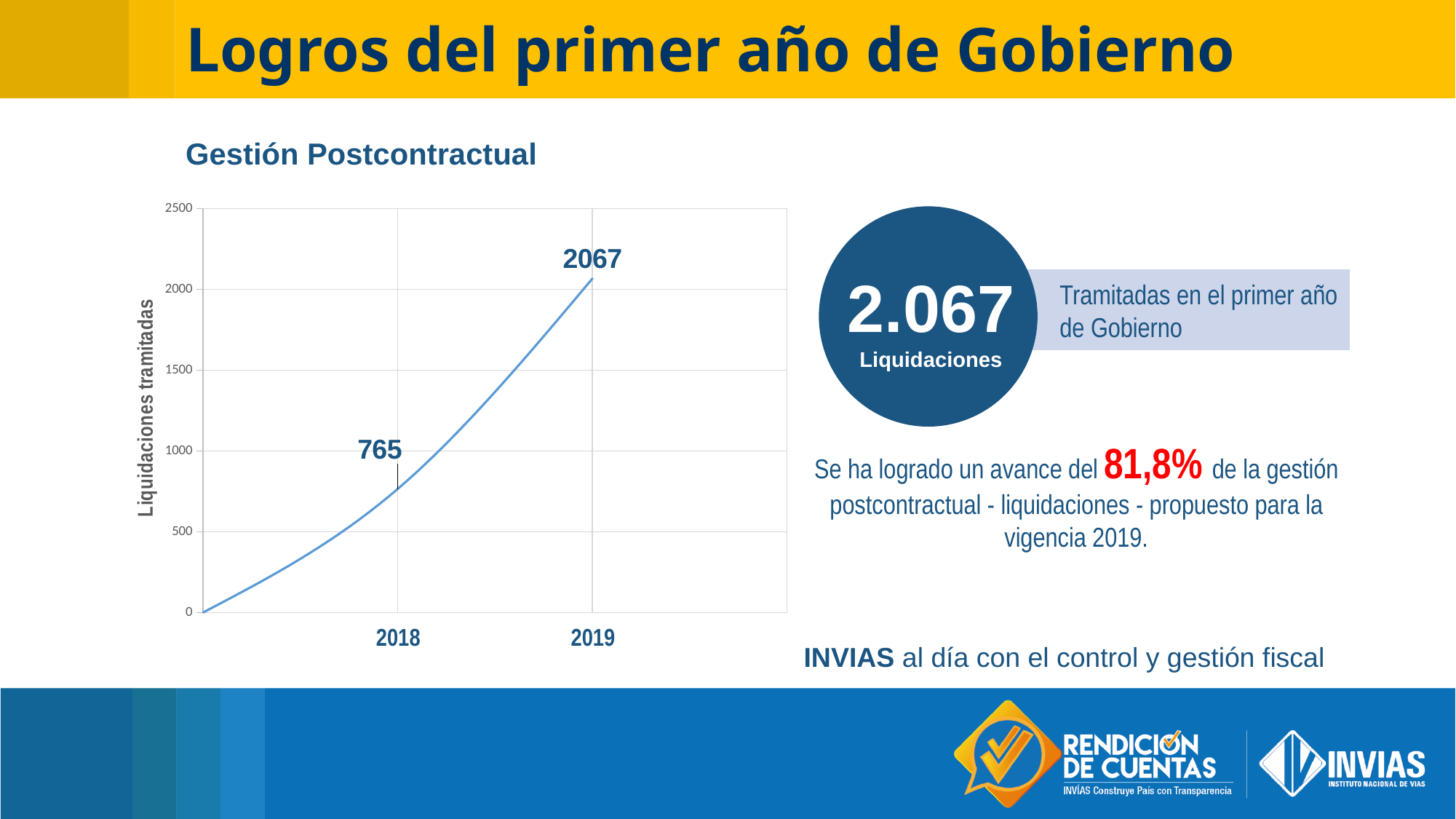
Is the value for 2018 greater or less than 1000? less What is the difference between the 2019 value and the 2018 value? 1302 How many years are labeled on the horizontal axis? 2 Which labeled year has the lowest value on the chart? 2018 What is the label of the vertical axis? Liquidaciones tramitadas What is the value of liquidaciones tramitadas for 2018? 765 Is the value for 2019 greater or less than 2000? greater Which year has the higher value, 2018 or 2019? 2019 What type of chart is shown on the slide? line chart What is the value of liquidaciones tramitadas for 2019? 2067 Does the line rise or fall from 2018 to 2019? rises What is the maximum value shown on the vertical axis? 2500